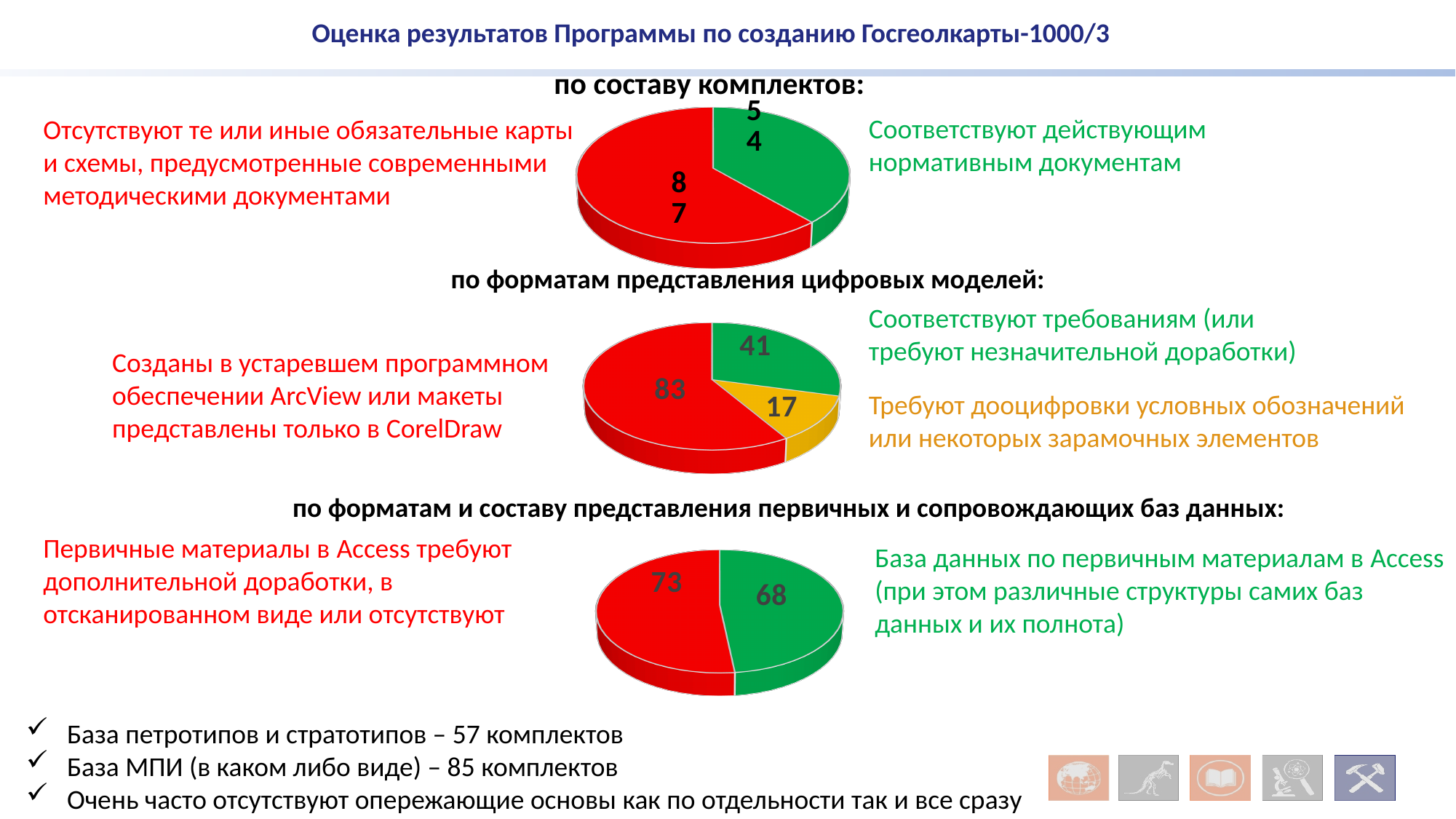
In the chart titled 'по форматам и составу представления первичных и сопровождающих баз данных:', what is the difference between the red slice (73) and the green slice (68)? 5 In the chart titled 'по форматам представления цифровых моделей:', what is the value of the yellow slice (Требуют дооцифровки условных обозначений или некоторых зарамочных элементов)? 17 In the chart titled 'по форматам и составу представления первичных и сопровождающих баз данных:', what is the value of the green slice (База данных по первичным материалам в Access)? 68 In the chart titled 'по форматам представления цифровых моделей:', which category has the largest value? Созданы в устаревшем программном обеспечении ArcView или макеты представлены только в CorelDraw (83) How many pie charts are shown on the slide? 3 In the chart titled 'по форматам представления цифровых моделей:', what is the total of all three slices? 141 In the chart titled 'по форматам и составу представления первичных и сопровождающих баз данных:', which is larger: the red slice or the green slice? the red slice (73) What kind of chart is used in the chart titled 'по форматам представления цифровых моделей:'? pie chart How many slices does the chart titled 'по форматам представления цифровых моделей:' have? 3 In the chart titled 'по составу комплектов:', what is the value of the red slice (Отсутствуют те или иные обязательные карты и схемы)? 87 In the chart titled 'по форматам представления цифровых моделей:', what is the difference between the red slice (83) and the green slice (41)? 42 In the chart titled 'по форматам представления цифровых моделей:', what is the value of the green slice (Соответствуют требованиям)? 41